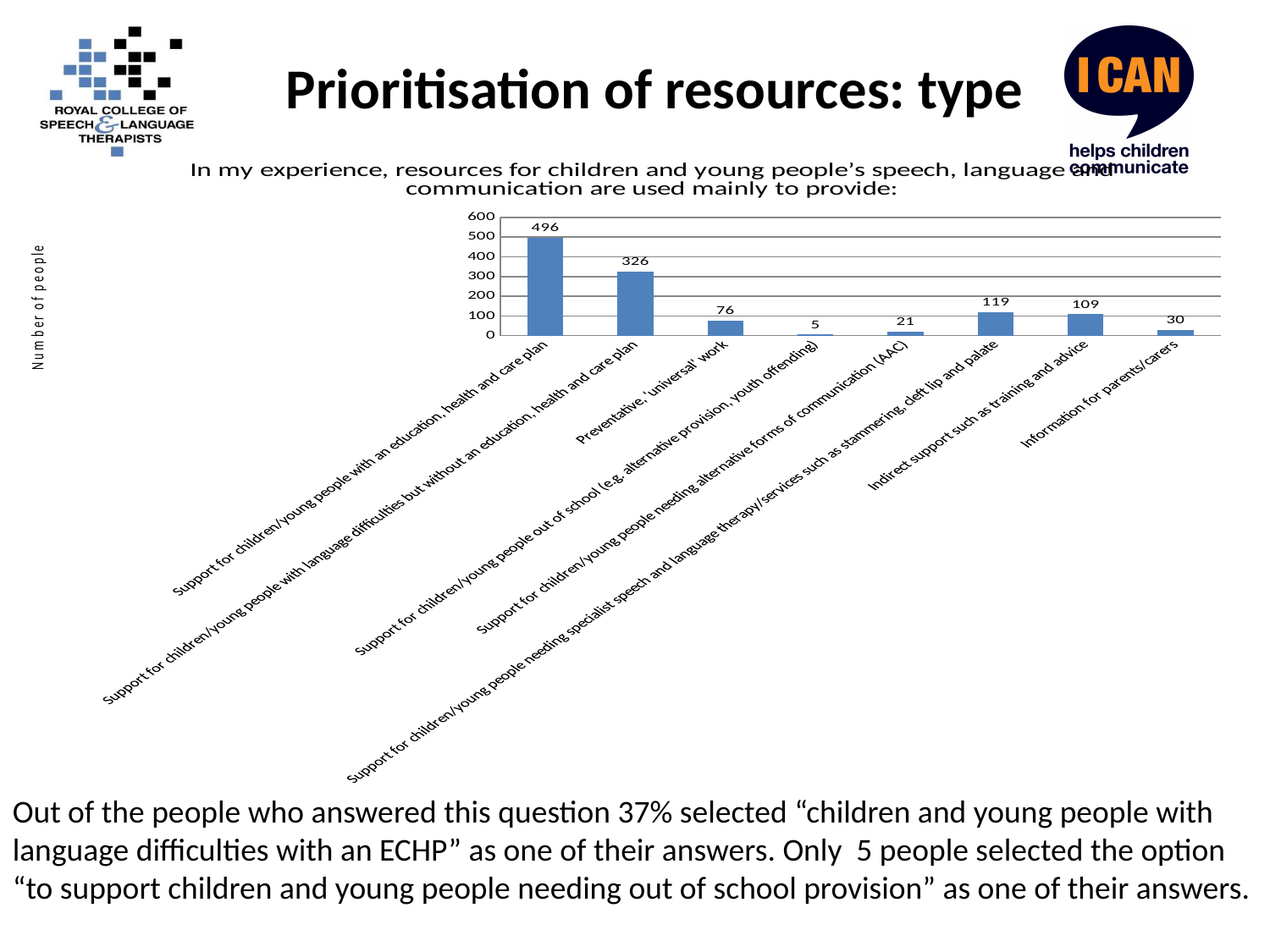
What is the value for 'Support for children/young people with an education, health and care plan'? 496 What kind of chart is shown on the slide? Bar chart What is the value for 'Indirect support such as training and advice'? 109 What is the difference between the values for 'Support for children/young people with an education, health and care plan' and 'Support for children/young people with language difficulties but without an education, health and care plan'? 170 How many categories are shown in the chart? 8 Which category has the lowest value? Support for children/young people out of school (e.g. alternative provision, youth offending) Which is larger: the value for 'Support for children/young people needing specialist speech and language therapy/services such as stammering, cleft lip and palate' or the value for 'Indirect support such as training and advice'? Support for children/young people needing specialist speech and language therapy/services such as stammering, cleft lip and palate What is the value for 'Preventative, 'universal' work'? 76 Is the value for 'Support for children/young people with language difficulties but without an education, health and care plan' greater or less than 300? greater Which category has the highest value? Support for children/young people with an education, health and care plan What is the value for 'Information for parents/carers'? 30 What is the label on the vertical axis of the chart? Number of people